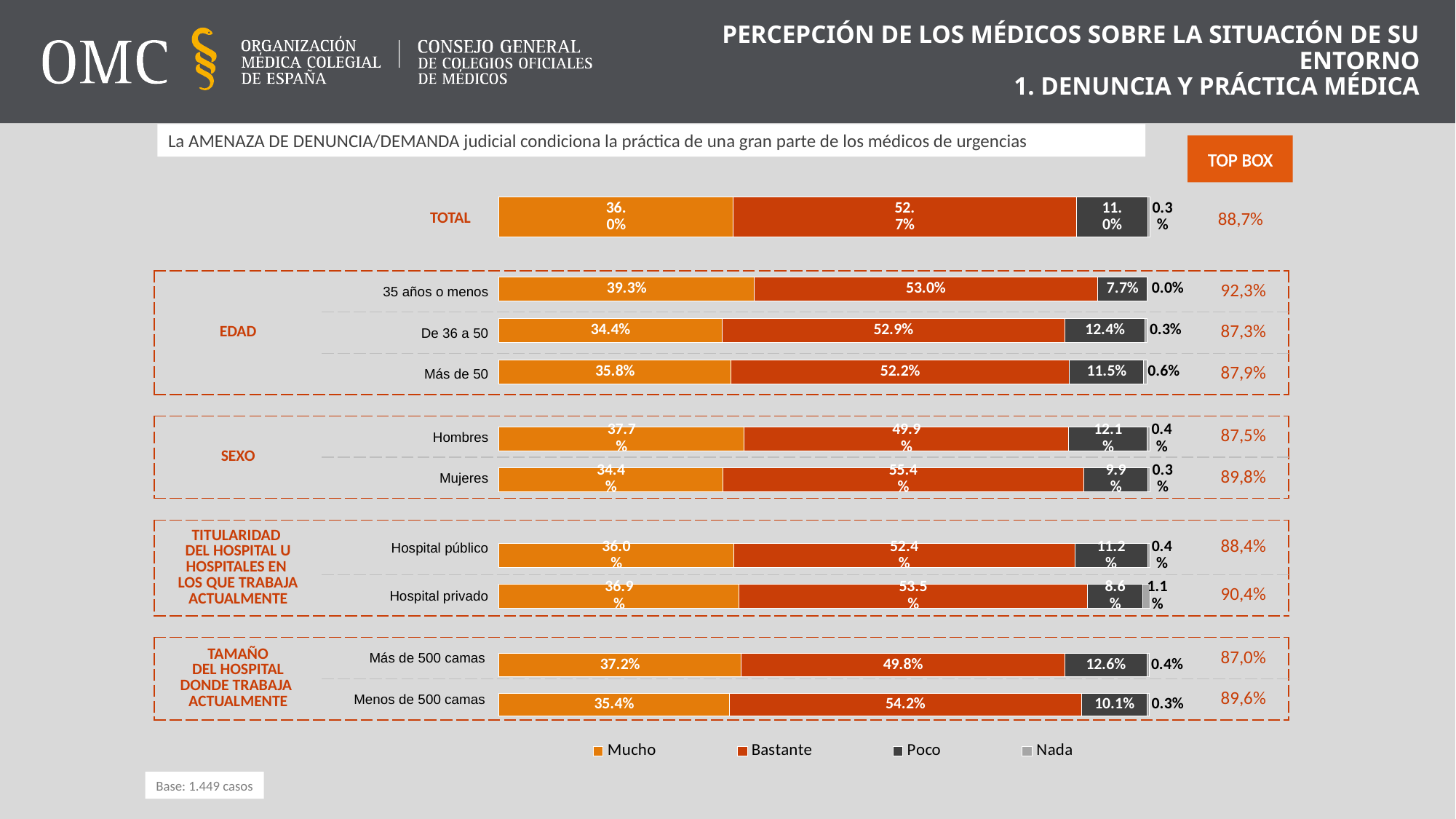
What is the TOP BOX value shown for TOTAL? 88,7% What is the 'Nada' value for 'Hospital privado'? 1.1% What kind of chart is shown on the slide? Stacked bar chart Which category has the highest 'Mucho' value? 35 años o menos Which has a larger 'Mucho' value, 'Hombres' or 'Mujeres'? Hombres What is the difference between the 'Bastante' values for 'Mujeres' and 'Hombres'? 5.5 percentage points Which category has the lowest 'Poco' value? 35 años o menos How many series does the legend list? 4 What is the 'Poco' value for 'Más de 500 camas'? 12.6% What is the 'Bastante' value for 'Mujeres'? 55.4% How many bars (categories) are plotted in the chart, including TOTAL? 10 What percentage of the '35 años o menos' group answered 'Mucho'? 39.3%